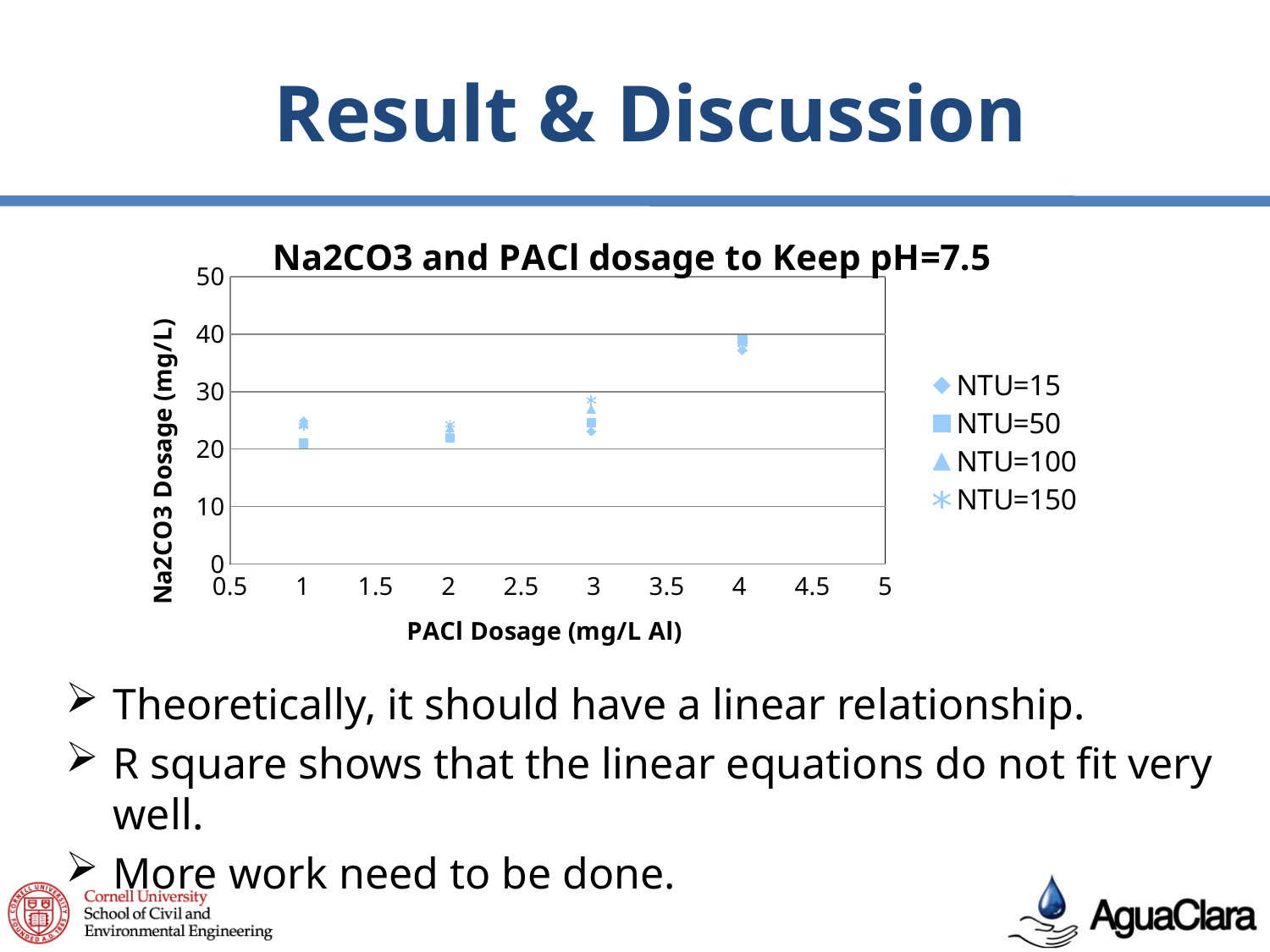
Is the Na2CO3 dosage for NTU=15 at a PACl dosage of 4 larger than at a PACl dosage of 1? Yes What is the title of the chart? Na2CO3 and PACl dosage to Keep pH=7.5 Is the Na2CO3 dosage for NTU=50 at a PACl dosage of 4 greater or less than 30? greater At how many PACl dosage values are data points plotted? 4 How many series does the chart's legend list? 4 What kind of chart is shown on the slide? Scatter chart Is the Na2CO3 dosage for NTU=100 at a PACl dosage of 2 greater or less than 10? greater Is the Na2CO3 dosage for NTU=15 at a PACl dosage of 1 greater or less than 30? less What is the label of the y axis? Na2CO3 Dosage (mg/L) Which PACl dosage has the highest Na2CO3 dosage values across all series? 4 Do the Na2CO3 dosage values generally rise or fall as PACl dosage increases from 1 to 4? rise